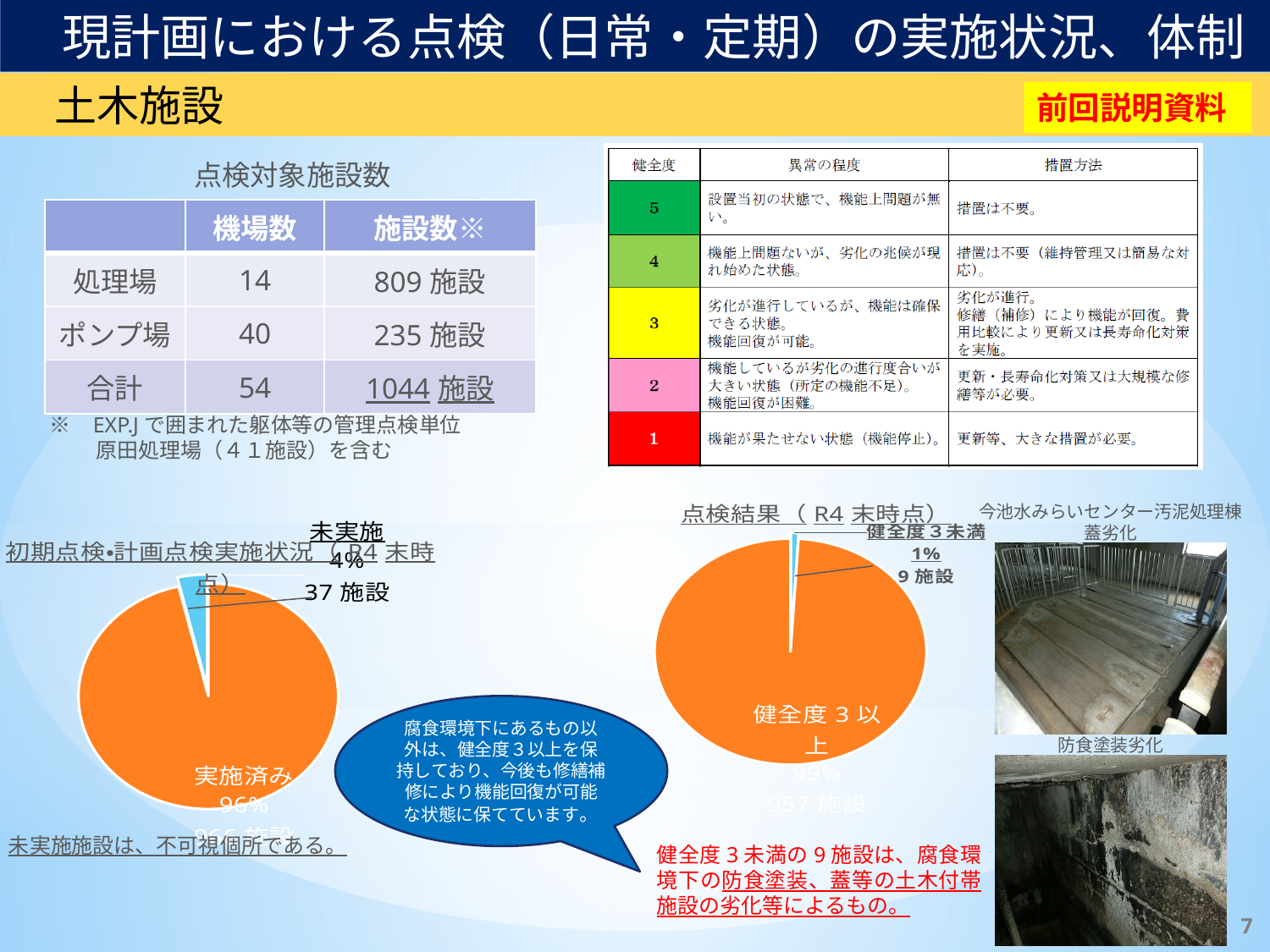
In the left pie chart (初期点検・計画点検実施状況), what percentage is shown for 実施済み? 96% In the left pie chart (初期点検・計画点検実施状況), which is larger, 実施済み or 未実施? 実施済み In the right pie chart (点検結果), how many facilities are labelled for 健全度3以上? 957 施設 In the right pie chart (点検結果), which slice is the smallest? 健全度3未満 How many slices does the left pie chart (初期点検・計画点検実施状況) have? 2 What type of chart is used for 点検結果 on the right? Pie chart In the left pie chart (初期点検・計画点検実施状況), how many facilities are labelled for 未実施? 37 施設 In the left pie chart (初期点検・計画点検実施状況), which slice is the largest? 実施済み In the left pie chart (初期点検・計画点検実施状況), what percentage is shown for 未実施? 4% In the right pie chart (点検結果), how many facilities are labelled for 健全度3未満? 9 施設 In the right pie chart (点検結果), what is the difference in percentage points between 健全度3以上 and 健全度3未満? 98 In the right pie chart (点検結果), what percentage is shown for 健全度3以上? 99%